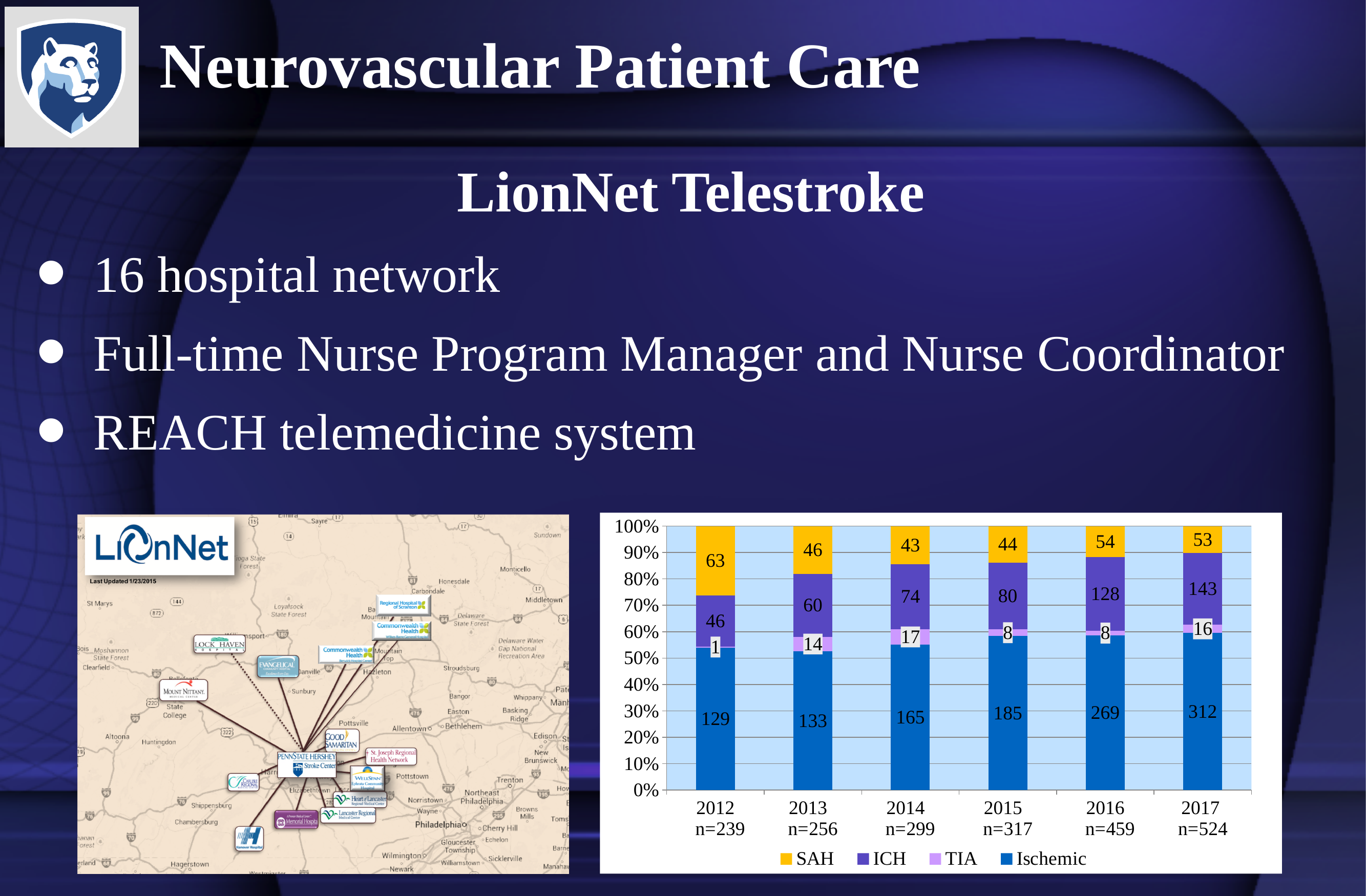
What is the ICH value for 2016? 128 What is the difference between the ICH value for 2017 and the ICH value for 2012? 97 What kind of chart is shown? Stacked bar chart Which year has the lowest TIA value? 2012 Do the Ischemic values rise or fall from 2012 to 2017? Rise How many series does the legend list? 4 Which year has the highest Ischemic value? 2017 Which year has the larger SAH value, 2012 or 2013? 2012 What is the SAH value for 2012? 63 How many years are shown on the x axis? 6 What is the TIA value for 2014? 17 What is the Ischemic value for 2017? 312